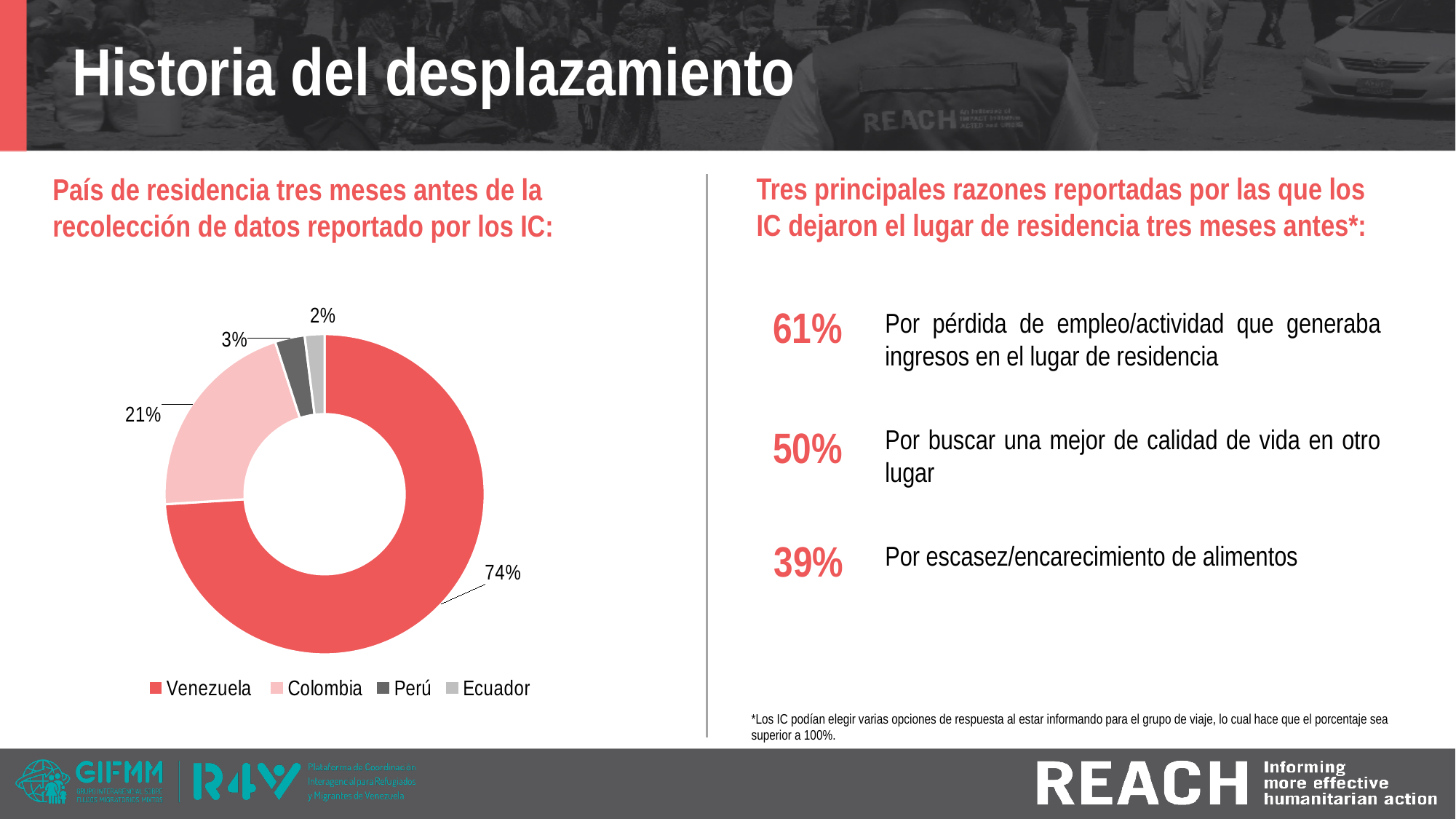
Which country has the largest slice in the pie chart? Venezuela Which country is shown in the lightest grey colour in the pie chart legend? Ecuador How many countries are shown in the pie chart? 4 What share of the pie chart does Venezuela represent? 74% What is the combined share of Perú and Ecuador in the pie chart? 5% What is the difference in percentage points between Venezuela and Colombia in the pie chart? 53 What percentage is shown for Ecuador in the pie chart? 2% Which has a larger share in the pie chart, Colombia or Perú? Colombia What percentage is shown for Perú in the pie chart? 3% What percentage is shown for Colombia in the pie chart? 21% What type of chart is used to show the country of residence three months before data collection? doughnut chart Which country has the smallest slice in the pie chart? Ecuador